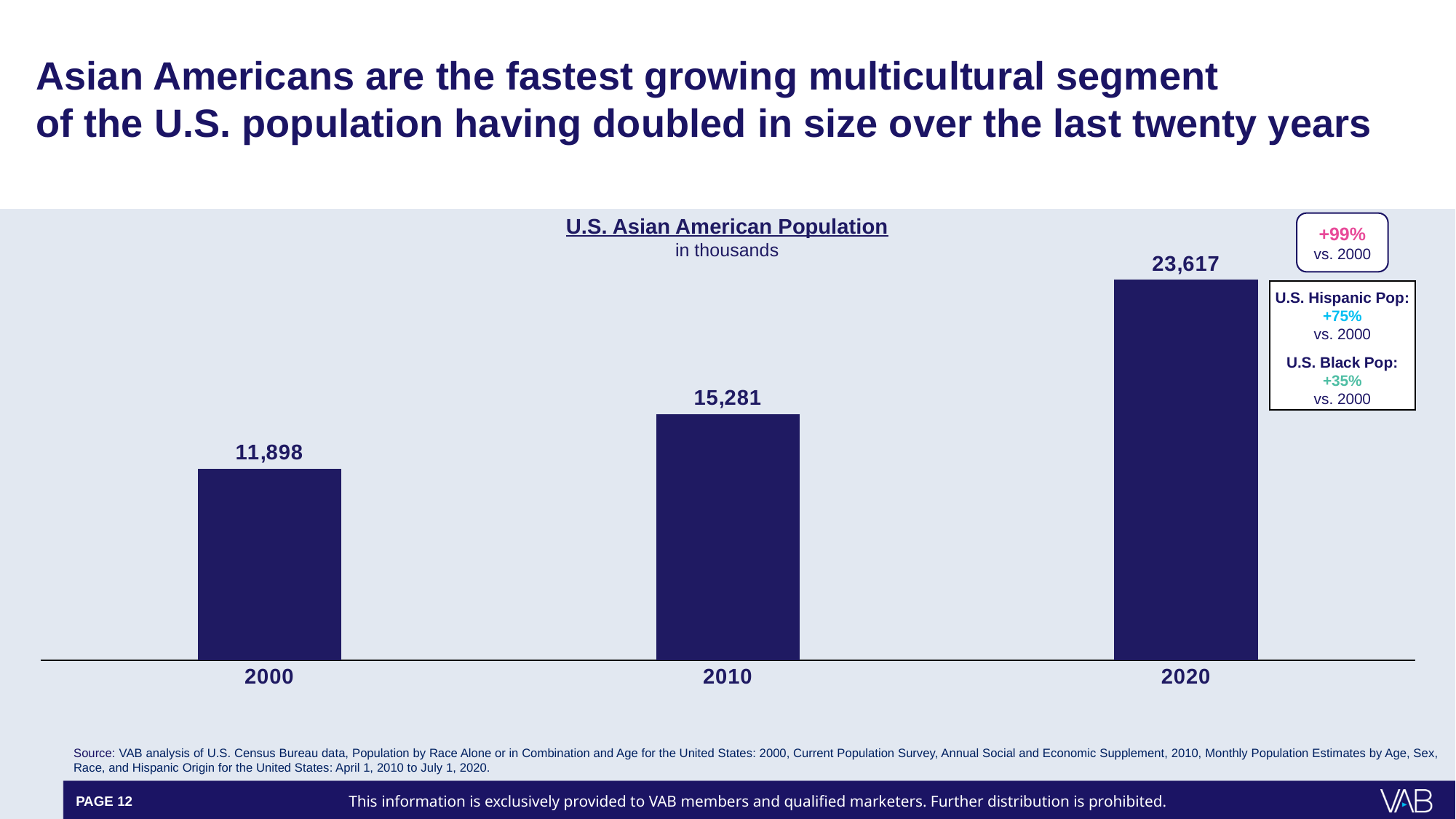
How many years (bars) are shown in the chart? 3 What is the difference between the 2020 and 2000 values in the chart? 11,719 What is the U.S. Asian American population (in thousands) shown for 2010? 15,281 What is the difference between the 2010 and 2000 values in the chart? 3,383 Which is larger, the value for 2010 or the value for 2020? 2020 What kind of chart is shown on the slide? Bar chart Which year has the highest U.S. Asian American population in the chart? 2020 What is the U.S. Asian American population (in thousands) shown for 2020? 23,617 Do the values rise or fall from 2000 to 2020? Rise Which year has the lowest U.S. Asian American population in the chart? 2000 What is the U.S. Asian American population (in thousands) shown for 2000? 11,898 What is the title of the chart? U.S. Asian American Population